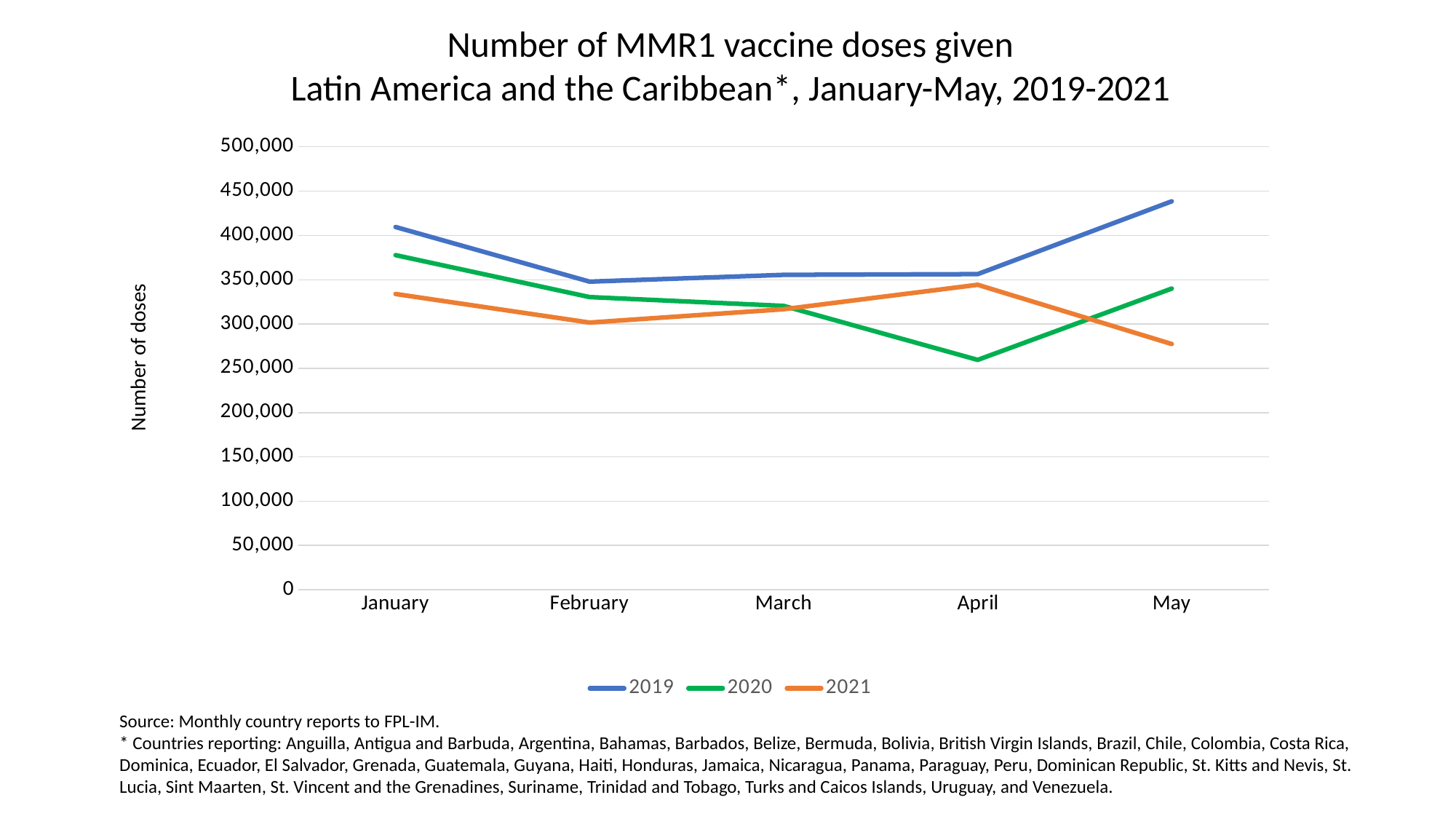
In May, which series has the larger value, 2019 or 2021? 2019 In which month is the 2021 series at its highest? April What is the label on the y axis? Number of doses Is the value for 2020 in April greater or less than 300,000? less How many months are shown on the x axis? 5 In which month is the 2020 series at its lowest? April In which month is the 2021 series at its lowest? May In April, which series has the larger value, 2020 or 2021? 2021 What type of chart is shown on the slide? Line chart How many series does the legend list? 3 In which month is the 2019 series at its highest? May Is the value for 2019 in January greater or less than 400,000? greater